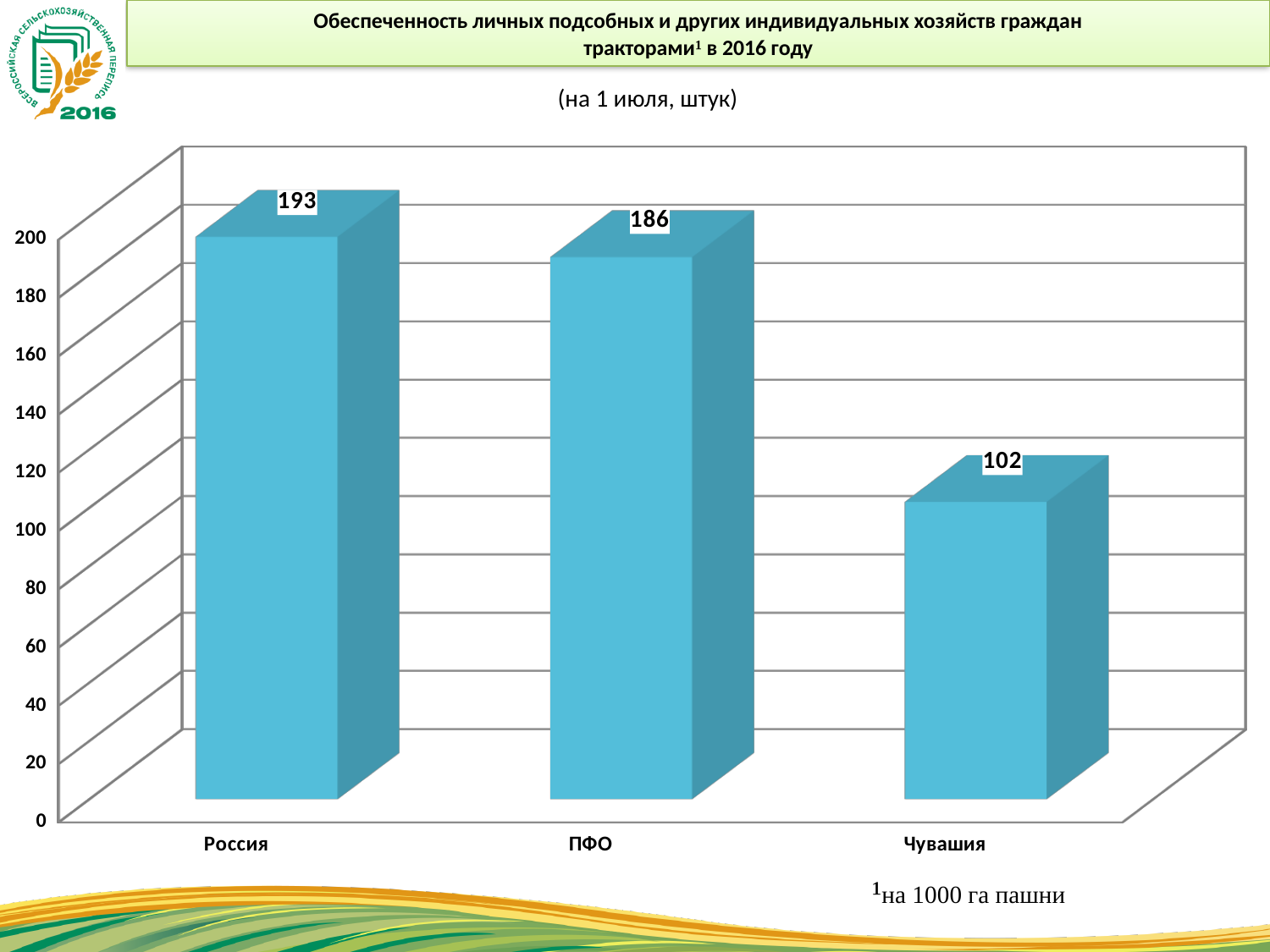
Do the values rise or fall from left to right along the x axis? fall What is the value for Чувашия? 102 What is the value for ПФО? 186 What kind of chart is shown on the slide? bar chart Which category has the highest value? Россия Which category has the lowest value? Чувашия Is the value for Чувашия greater or less than 120? less What is the difference between the values for Россия and Чувашия? 91 How many categories are shown on the chart? 3 Which is larger, the value for ПФО or the value for Чувашия? ПФО What is the value for Россия? 193 What is the difference between the values for Россия and ПФО? 7